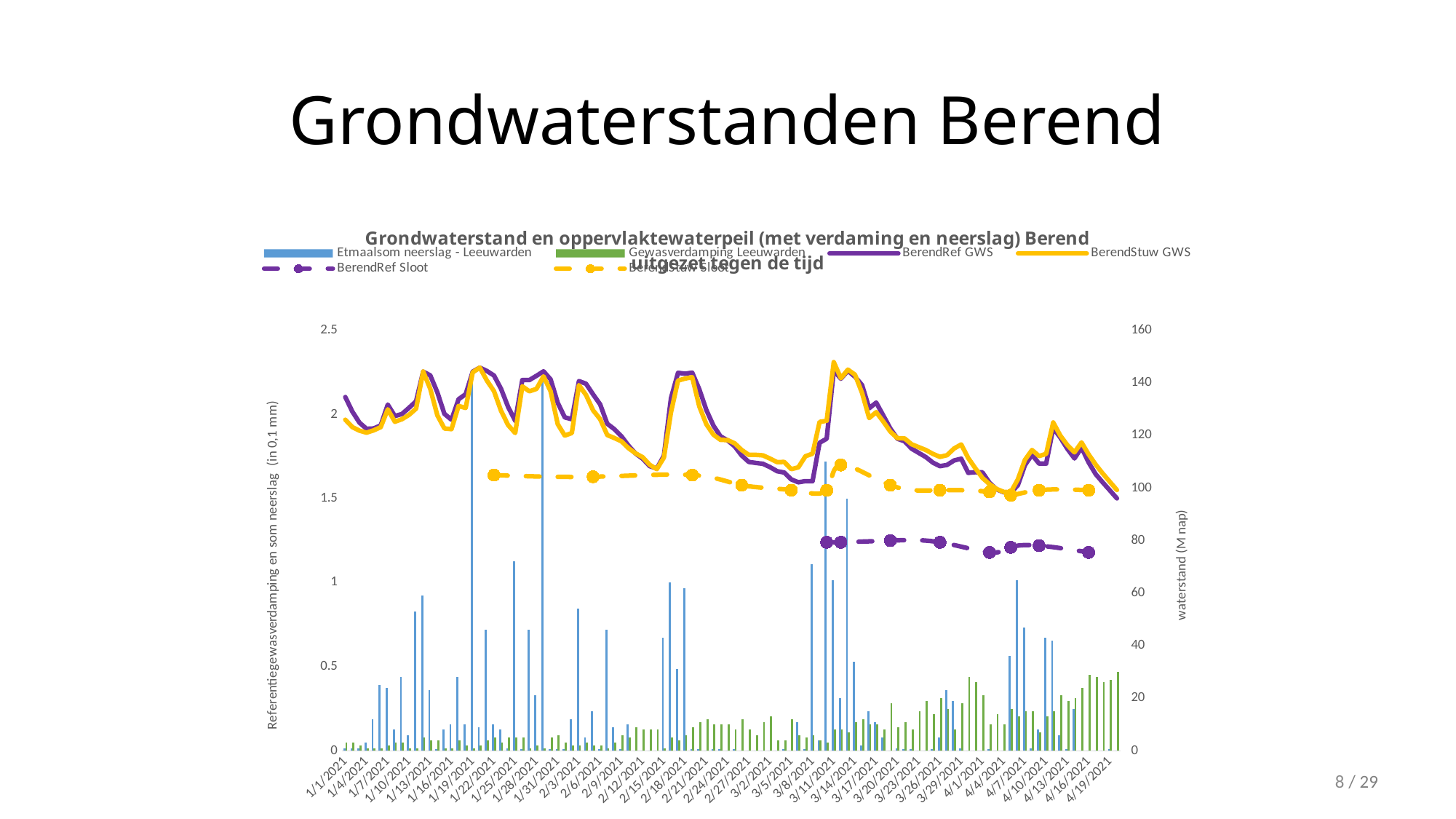
What is the title of the chart? Grondwaterstand en oppervlaktewaterpeil (met verdaming en neerslag) Berend uitgezet tegen de tijd Does the Gewasverdamping Leeuwarden series rise or fall overall from January to April? rise Is the value of the BerendStuw Sloot series greater or less than 80 on the right axis? greater Which series has higher values, BerendStuw Sloot or BerendRef Sloot? BerendStuw Sloot Are all Gewasverdamping Leeuwarden bars greater or less than 1 on the left axis? less Is the tallest Etmaalsom neerslag - Leeuwarden bar greater or less than 2 on the left axis? greater Which series is drawn as a solid purple line? BerendRef GWS What kind of chart is shown on the slide? A combined bar and line chart How many series does the chart legend list? 6 Does the BerendRef GWS line rise or fall overall from 3/14/2021 to 4/19/2021? fall What is the maximum value shown on the right-hand axis? 160